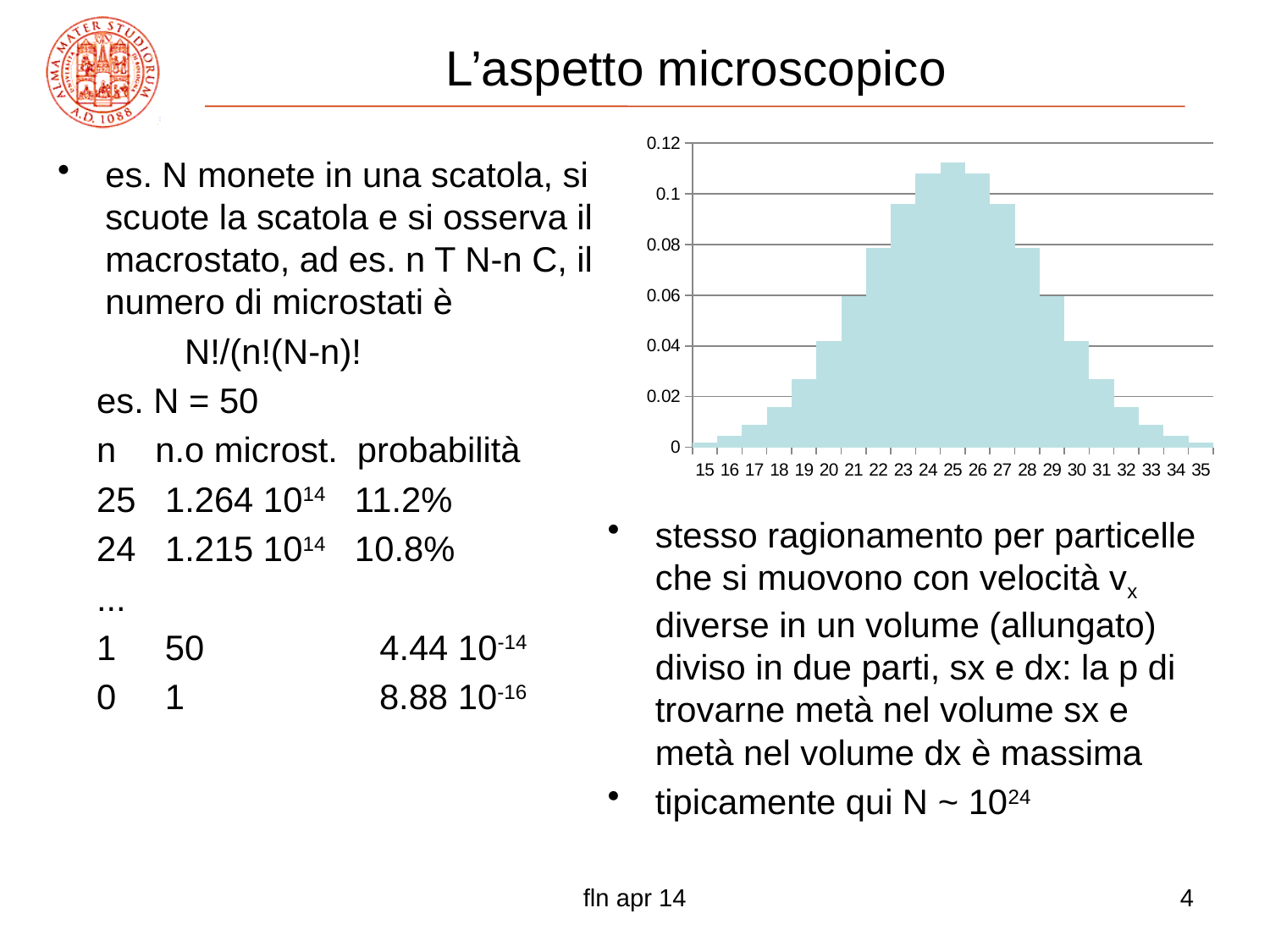
Is the value for 18 greater or less than 0.02? less Which category has the highest value in the chart? 25 How many categories are shown along the x axis of the chart? 21 Is the value for 27 greater or less than 0.08? greater Do the values rise or fall along the x axis from 15 to 25? rise Do the values rise or fall along the x axis from 25 to 35? fall Is the value for 20 greater or less than 0.06? less Which has the larger value, 25 or 20? 25 What kind of chart is shown on the slide? bar chart